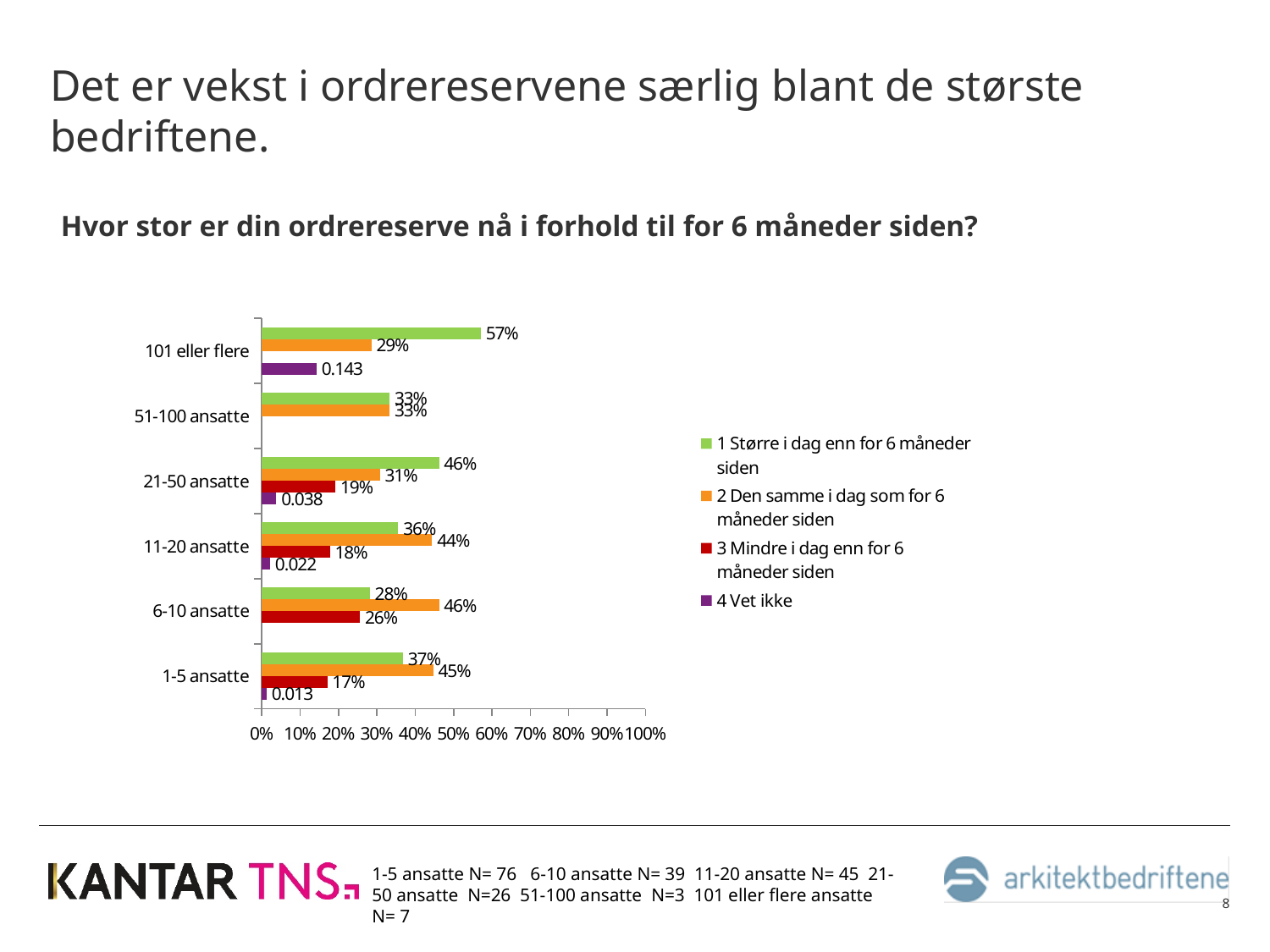
Which category has the lowest value for '1 Større i dag enn for 6 måneder siden'? 6-10 ansatte What is the value for '2 Den samme i dag som for 6 måneder siden' in the '6-10 ansatte' category? 46% How many categories are shown on the vertical axis of the chart? 6 What is the value for '4 Vet ikke' in the '1-5 ansatte' category? 0.013 What kind of chart is shown on the slide? Bar chart In the '11-20 ansatte' category, which is larger: '1 Større i dag enn for 6 måneder siden' or '2 Den samme i dag som for 6 måneder siden'? 2 Den samme i dag som for 6 måneder siden How many series does the legend list? 4 What is the value for '3 Mindre i dag enn for 6 måneder siden' in the '1-5 ansatte' category? 17% What is the value for '3 Mindre i dag enn for 6 måneder siden' in the '21-50 ansatte' category? 19% What is the difference between the '1 Større i dag enn for 6 måneder siden' and '2 Den samme i dag som for 6 måneder siden' values for '101 eller flere'? 28% What is the value for '1 Større i dag enn for 6 måneder siden' in the '101 eller flere' category? 57% Which category has the highest value for '1 Større i dag enn for 6 måneder siden'? 101 eller flere